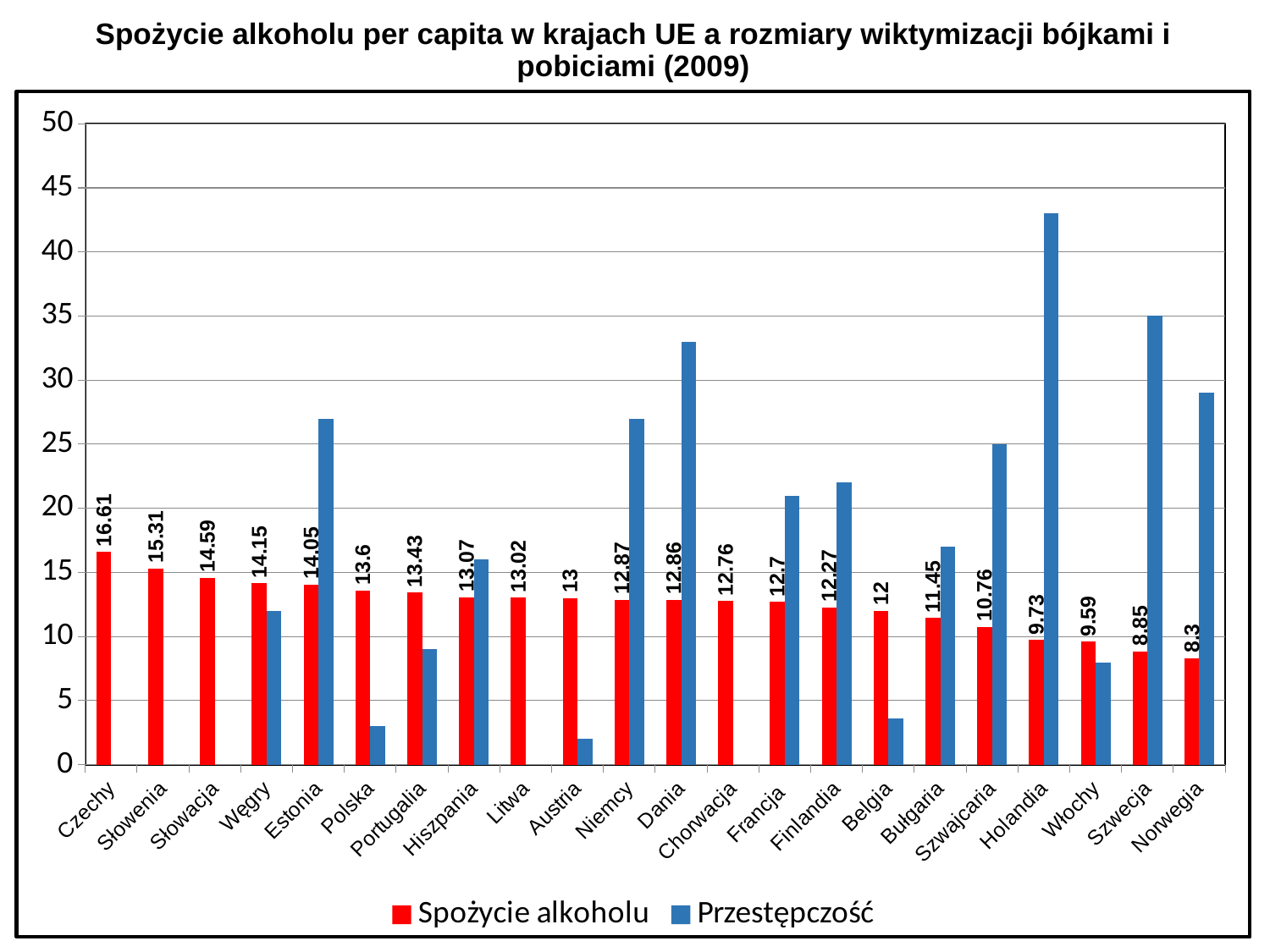
What is the Spożycie alkoholu value for Czechy? 16.61 How many series does the legend list? 2 Which country has the highest Przestępczość value? Holandia Which has the larger Spożycie alkoholu value, Francja or Finlandia? Francja Which country has the highest Spożycie alkoholu value? Czechy Which country has the lowest Spożycie alkoholu value? Norwegia Is the Przestępczość value for Holandia greater or less than 40? greater Is the Przestępczość value for Polska greater or less than 5? less What is the Spożycie alkoholu value for Polska? 13.6 How many countries are shown on the x axis? 22 Do the Spożycie alkoholu values rise or fall from left to right along the x axis? fall What is the difference between the Spożycie alkoholu values for Czechy and Norwegia? 8.31